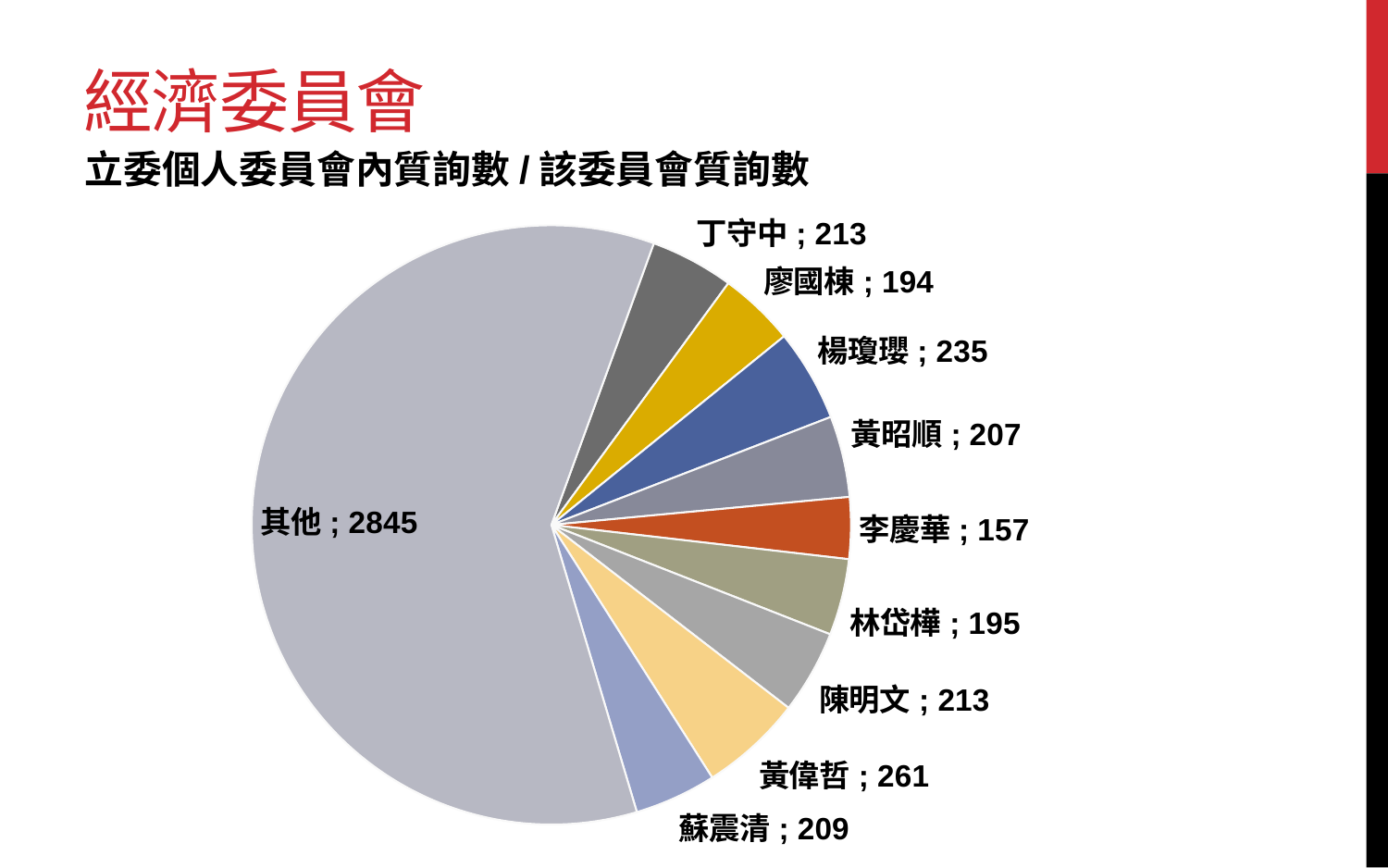
What is the subtitle shown above the chart? 立委個人委員會內質詢數 / 該委員會質詢數 What kind of chart is shown on the slide? pie chart Which slice of the pie has the smallest value? 李慶華 What is the value for 李慶華? 157 What is the value for 黃偉哲? 261 What is the value for 其他? 2845 What is the value for 丁守中? 213 Which is larger, the value for 楊瓊瓔 or the value for 黃昭順? 楊瓊瓔 Excluding 其他, which legislator has the highest value? 黃偉哲 Which slice of the pie is the largest? 其他 How many slices does the pie chart have? 10 What is the difference between the values for 黃偉哲 and 李慶華? 104